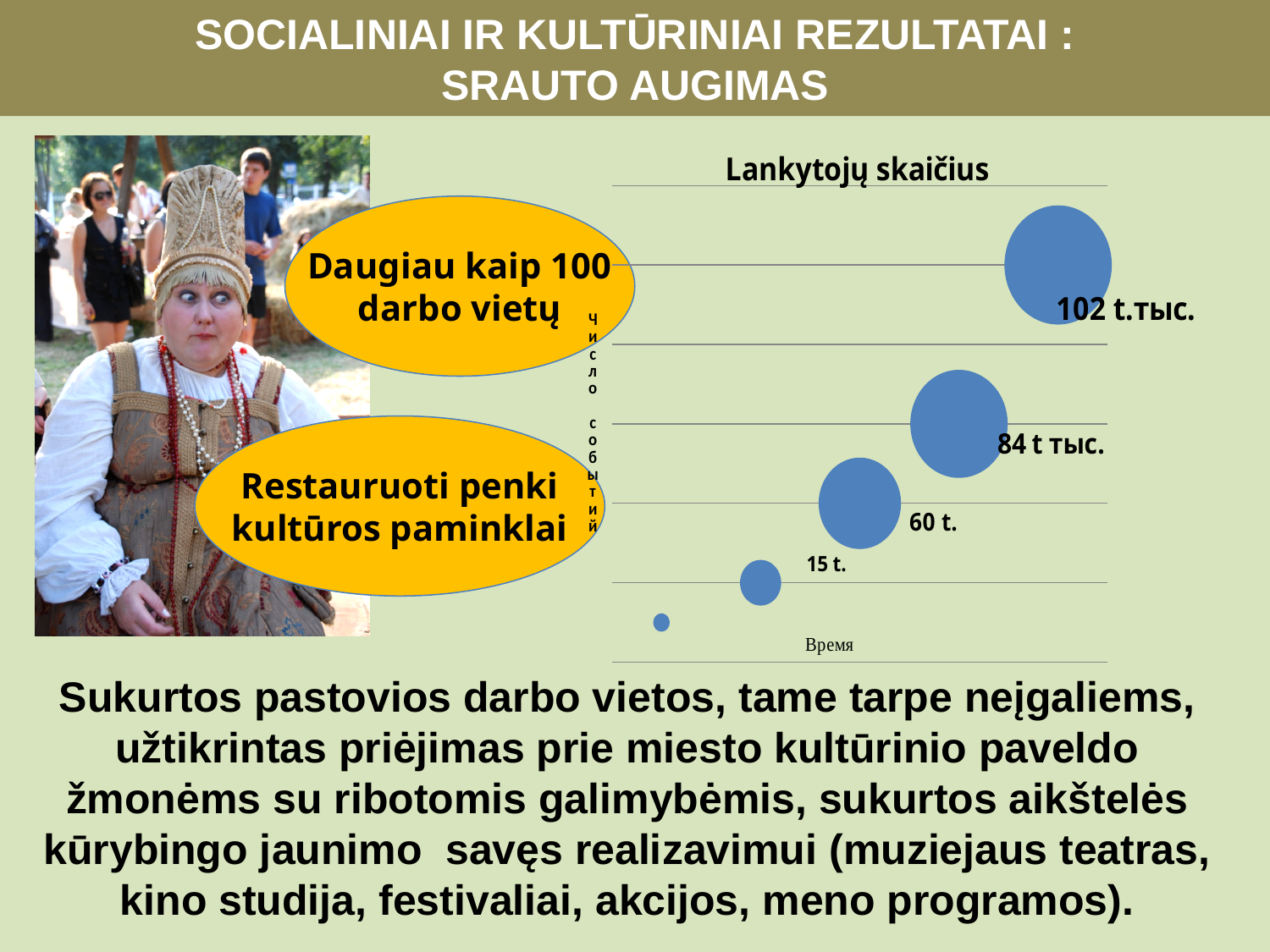
How many bubbles in the chart carry a data label? 4 Do the bubble values rise or fall from left to right along the time axis? rise How many bubbles are plotted in the chart in total? 5 What is the difference between the bubble labelled 60 t. and the bubble labelled 15 t.? 45 t. What kind of chart is shown on the slide? bubble chart What value is labelled on the largest bubble in the chart? 102 t.тыс. What is the lowest labelled value in the chart? 15 t. What value is labelled on the second-largest bubble in the chart? 84 t тыс. What is the highest labelled value in the chart? 102 t.тыс. Which is larger, the bubble labelled 84 t тыс. or the bubble labelled 60 t.? 84 t тыс. What is the title of the chart? Lankytojų skaičius What is the label on the horizontal axis of the chart? Время